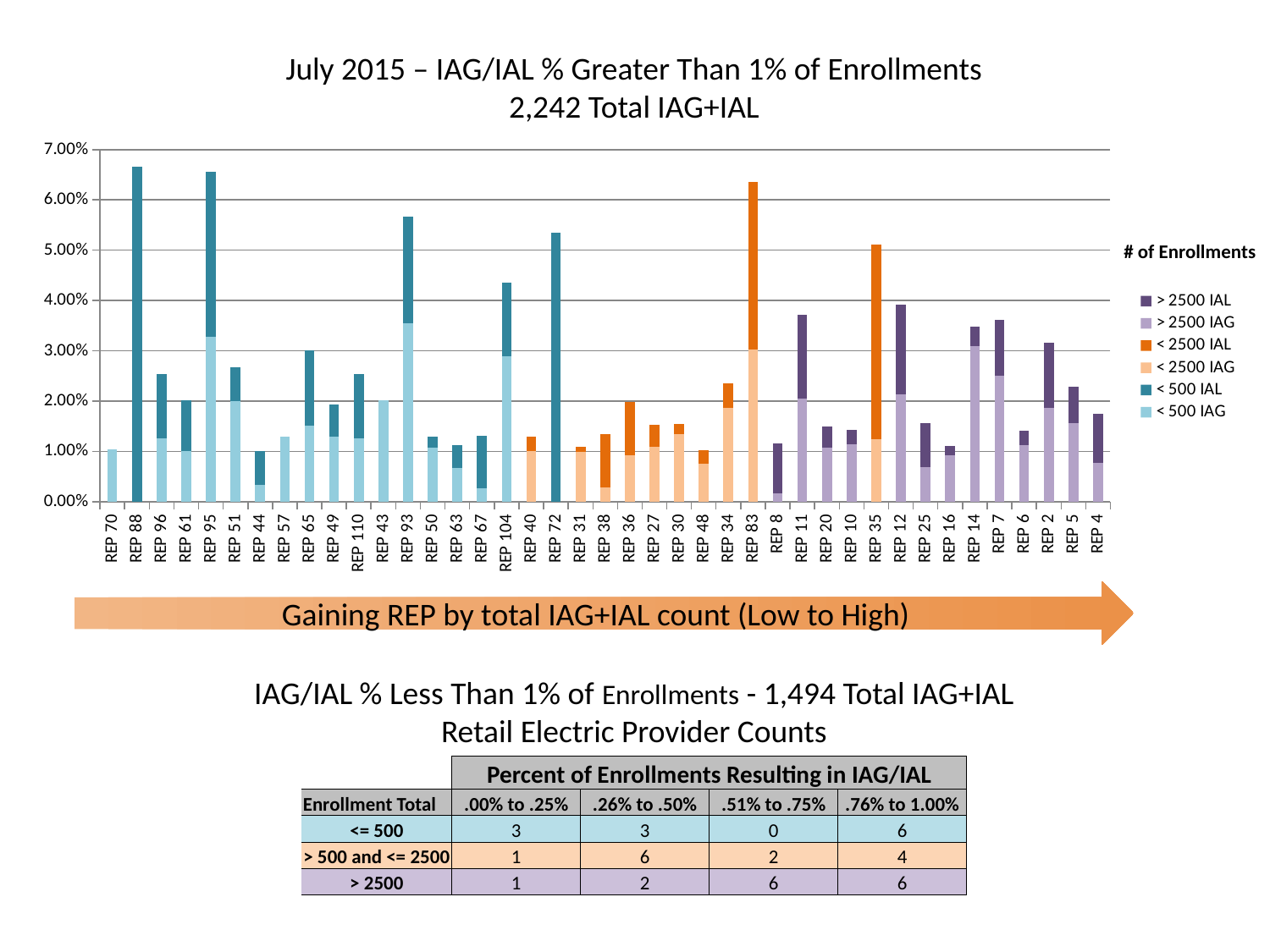
How many REP categories are plotted along the x axis of the chart? 41 Which has the larger total value, REP 88 or REP 72? REP 88 Which has the larger total value, REP 83 or REP 35? REP 83 Is the value for REP 8 greater or less than 2.00%? less What is the title of the chart? July 2015 – IAG/IAL % Greater Than 1% of Enrollments 2,242 Total IAG+IAL Is the value for REP 88 greater or less than 6.00%? greater How many series does the chart legend list? 6 What heading appears above the chart legend? # of Enrollments Is the value for REP 72 greater or less than 5.00%? greater What kind of chart is shown on the slide? Stacked bar chart